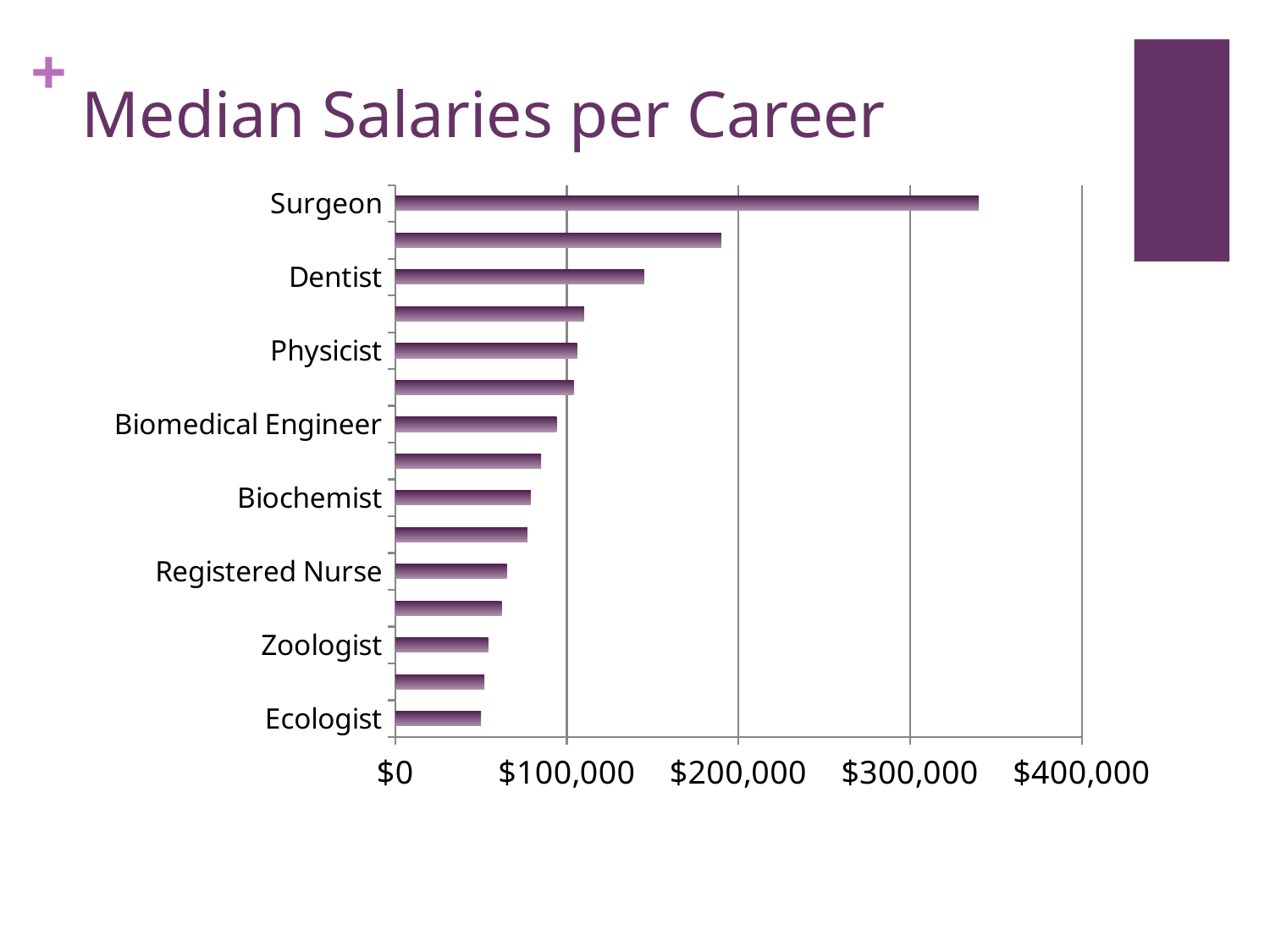
Which career has the highest median salary in the chart? Surgeon Which has a higher median salary, Surgeon or Dentist? Surgeon What is the title of the chart? Median Salaries per Career Is the median salary for Surgeon greater or less than $400,000? less Is the median salary for Registered Nurse greater or less than $100,000? less Is the median salary for Surgeon greater or less than $300,000? greater Which has a higher median salary, Physicist or Ecologist? Physicist How many bars are plotted in the chart? 15 What kind of chart is shown on the slide? bar chart